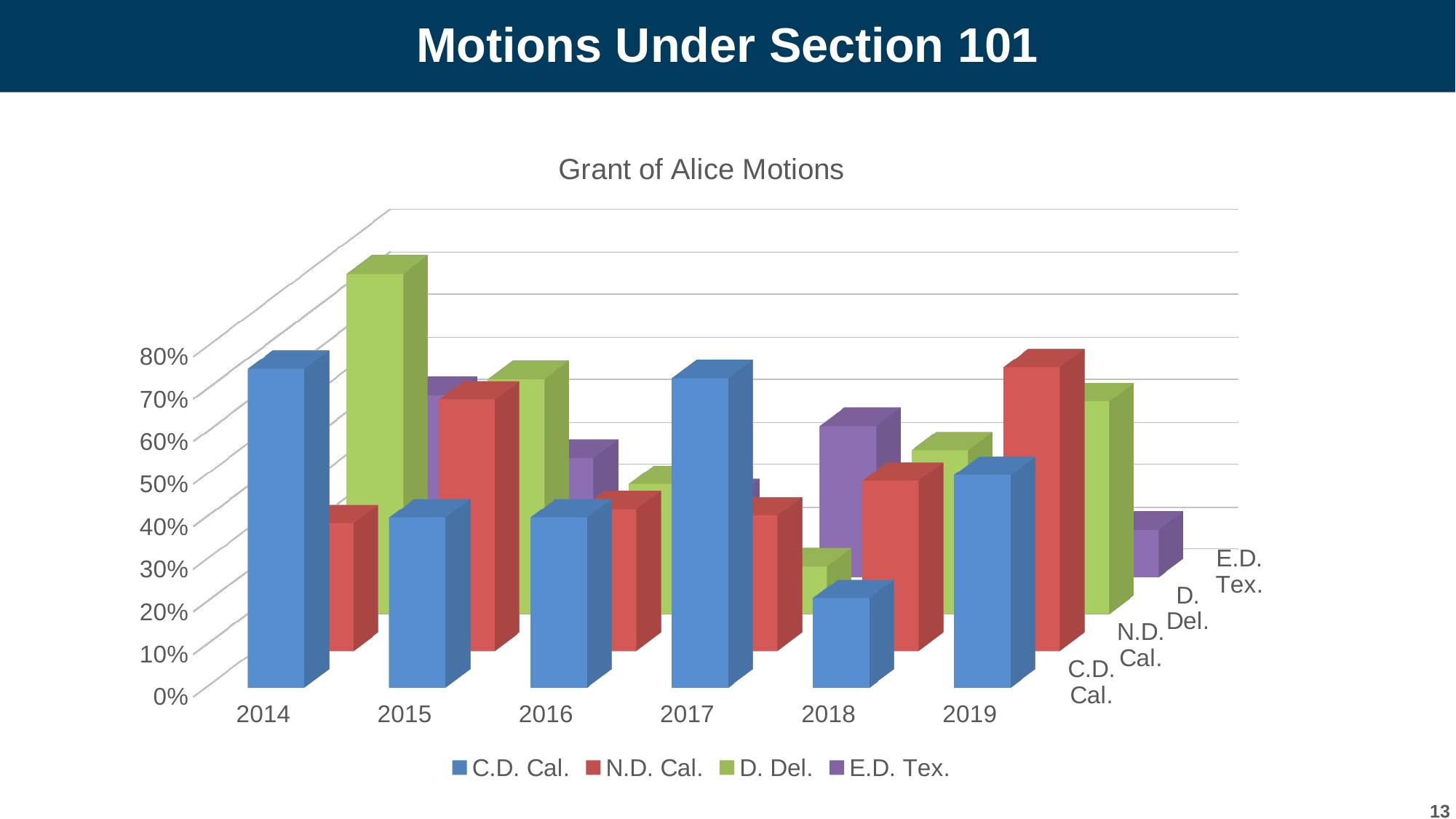
Which is larger, the D. Del. value in 2015 or in 2018? 2015 How many years are shown on the x axis? 6 Is the value for C.D. Cal. in 2014 greater or less than 50%? greater Which year has the highest value for D. Del.? 2014 Which colour represents D. Del. in the legend? green What kind of chart is shown on the slide? bar chart Which year has the lowest value for C.D. Cal.? 2018 Is the value for C.D. Cal. in 2018 greater or less than 40%? less Which is larger, the C.D. Cal. value in 2017 or in 2018? 2017 How many series does the legend list? 4 What is the title of the chart? Grant of Alice Motions